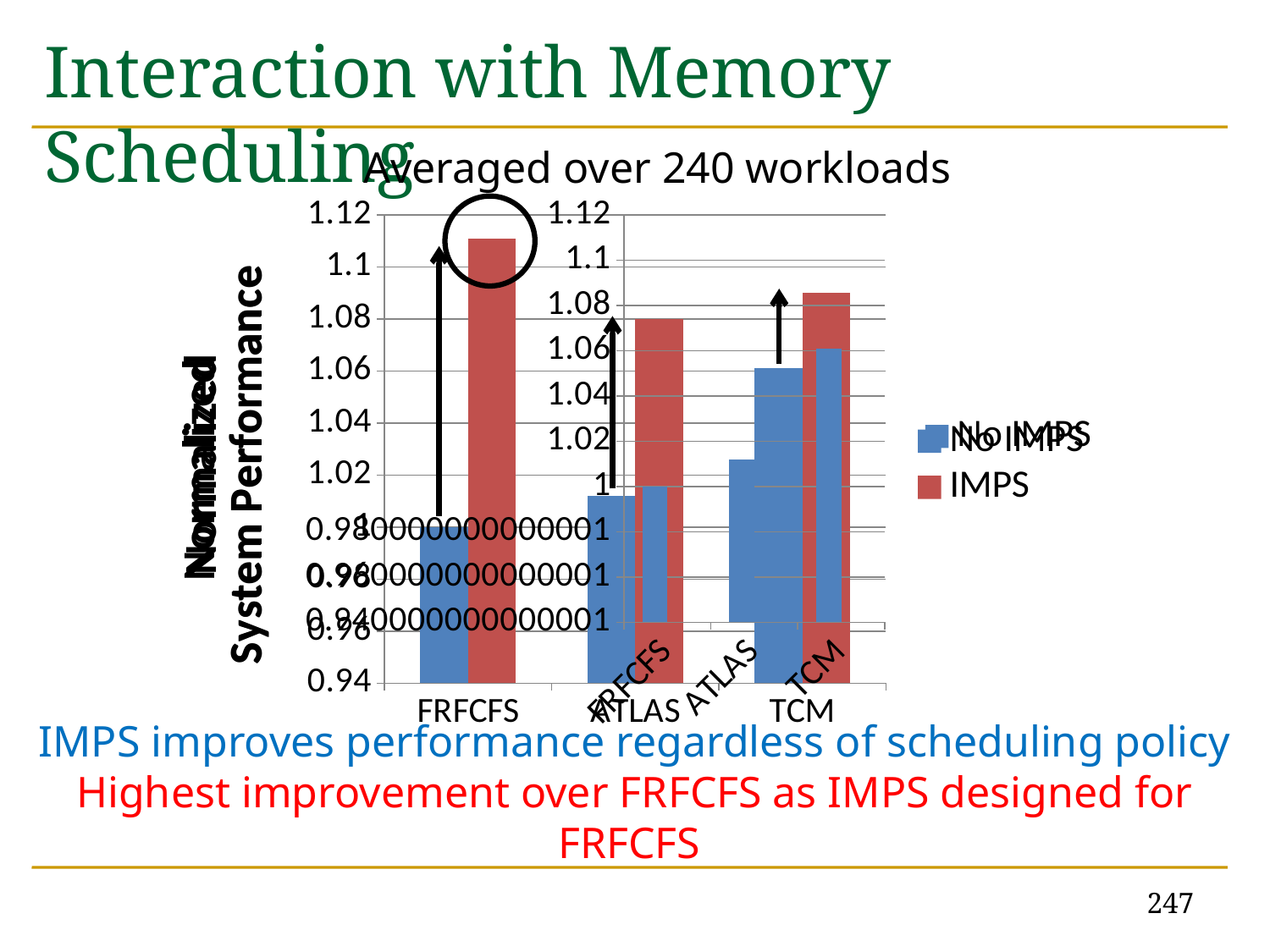
In the larger chart, is the IMPS value for TCM greater or less than 1.06? greater What is the title printed above the chart? Averaged over 240 workloads For FRFCFS, which series has the larger value, No IMPS or IMPS? IMPS What kind of chart is shown on the slide? bar chart Which category has the lowest No IMPS value? FRFCFS In the larger chart, is the IMPS value for FRFCFS greater or less than 1.1? greater How many series does the chart legend list? 2 Do the No IMPS values rise or fall going from FRFCFS to ATLAS to TCM? rise Which category has the highest IMPS value? FRFCFS How many scheduling policy categories are shown on the x axis of the chart? 3 What are the two series named in the chart legend? No IMPS and IMPS